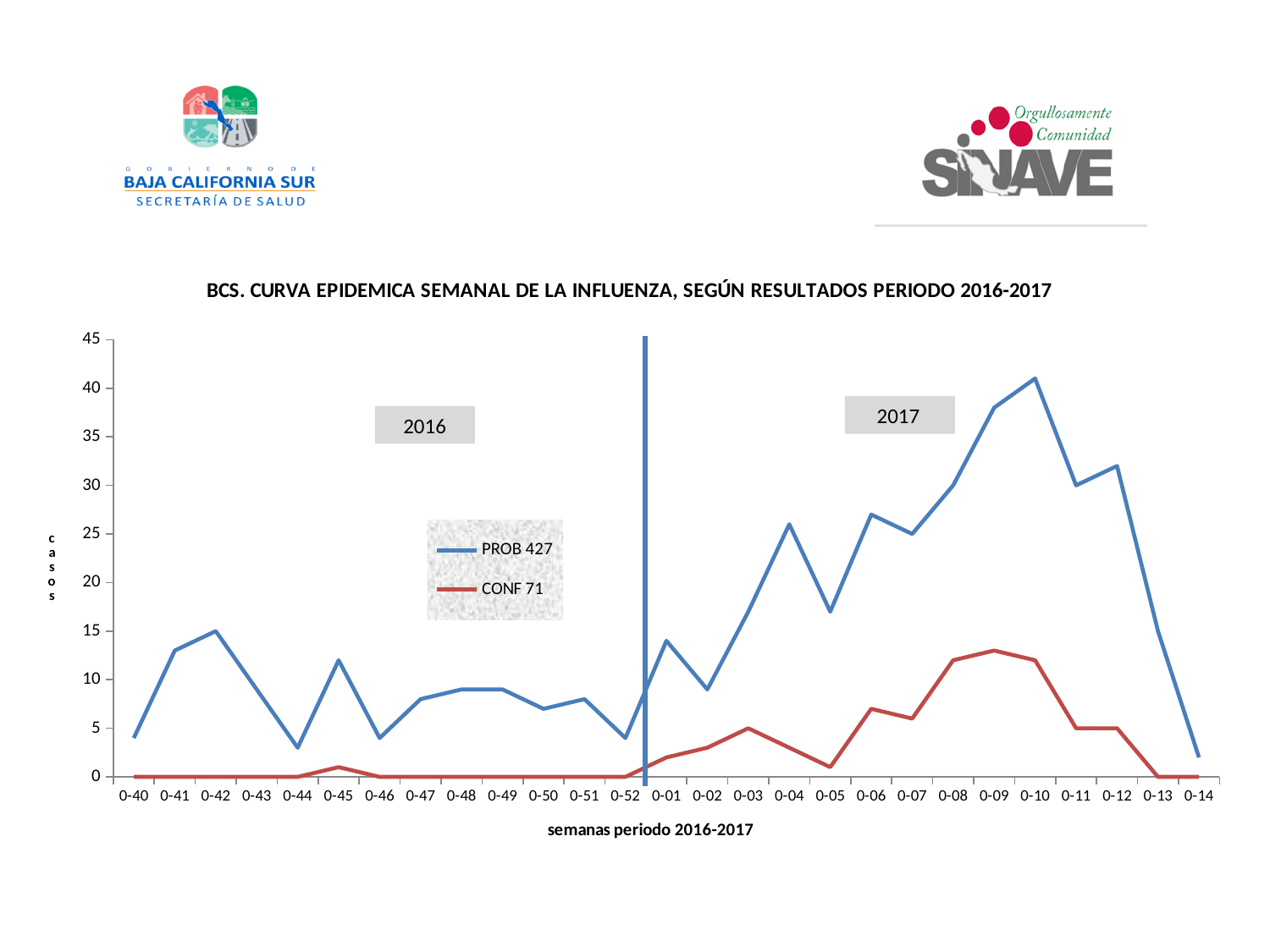
Is the value of PROB 427 in week 0-04 greater or less than 25? greater How many series does the legend list? 2 Does the PROB 427 series rise or fall from week 0-10 to week 0-14? fall In which week does the PROB 427 series reach its highest value? 0-10 What kind of chart is shown on the slide? line chart How many weeks are plotted along the x axis? 27 What are the two series named in the legend? PROB 427 and CONF 71 Which is larger, the PROB 427 value in week 0-04 or in week 0-05? 0-04 In which week does the CONF 71 series reach its highest value? 0-09 Is the value of PROB 427 in week 0-10 greater or less than 40? greater What is the label of the x axis? semanas periodo 2016-2017 Is the value of CONF 71 in week 0-09 greater or less than 15? less